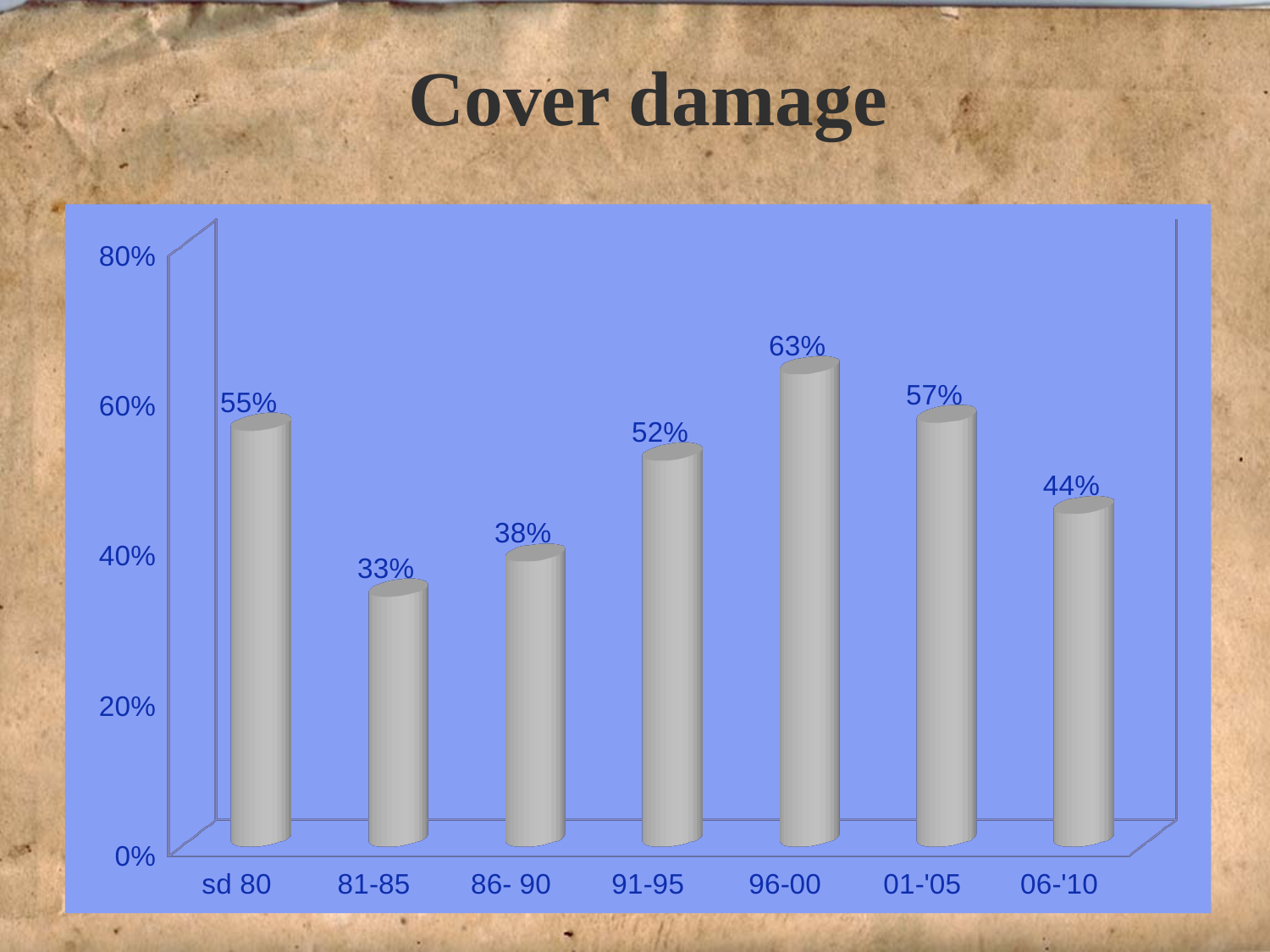
Which period has a larger cover damage value, sd 80 or 91-95? sd 80 What is the title of the chart? Cover damage What kind of chart is shown on the slide? bar chart Which period has the highest cover damage value? 96-00 Is the cover damage value for 86- 90 greater or less than 40%? less What is the cover damage value for the 06-'10 period? 44% What is the cover damage value for the 81-85 period? 33% What is the difference between the cover damage values for 96-00 and 81-85? 30% What is the difference between the cover damage values for 01-'05 and 06-'10? 13% What is the cover damage value for the 96-00 period? 63% How many periods are shown on the x axis of the chart? 7 Which period has the lowest cover damage value? 81-85